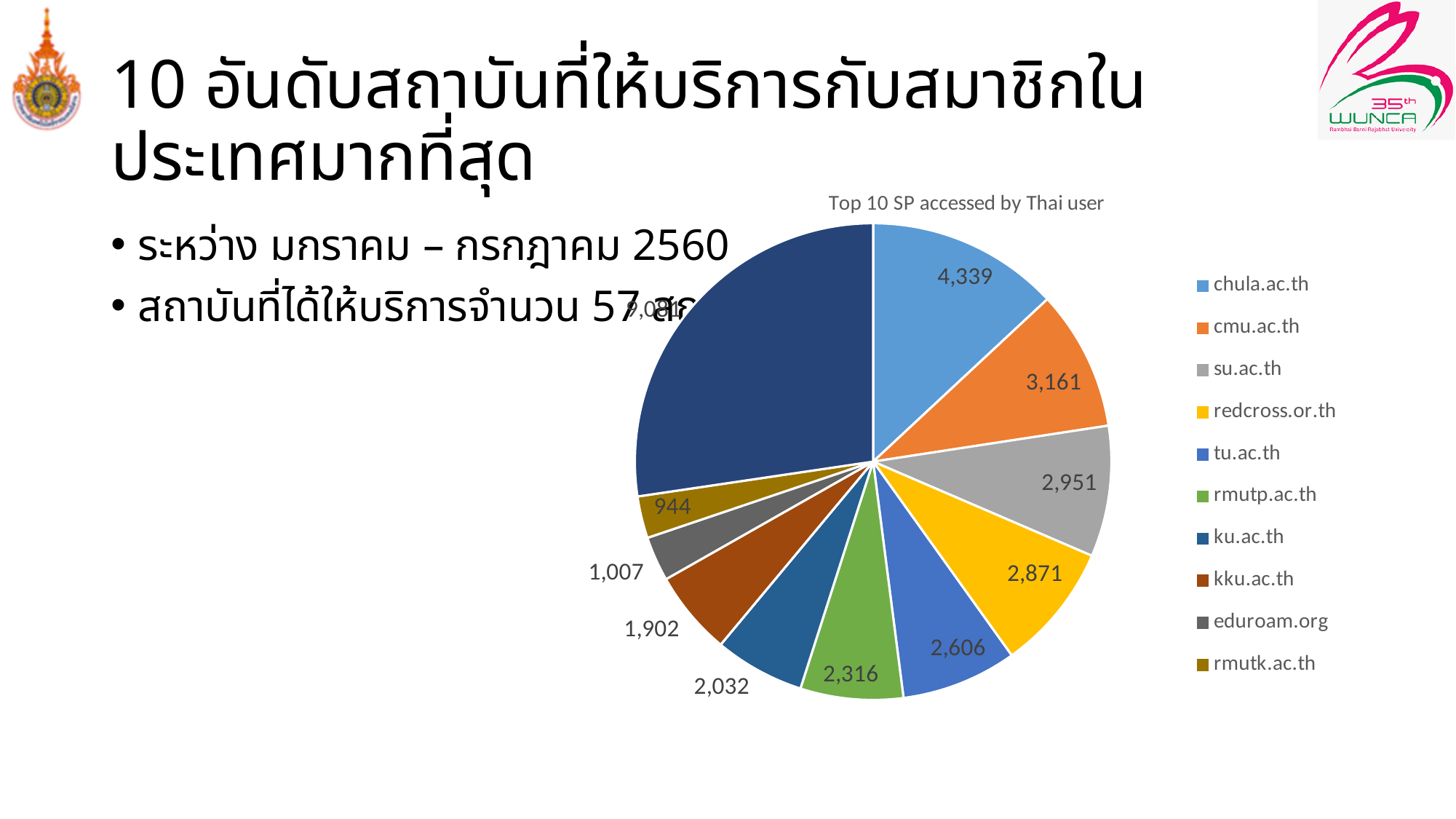
What is the difference between the values for tu.ac.th and rmutp.ac.th? 290 Which is larger, the value for cmu.ac.th or su.ac.th? cmu.ac.th What is the value for eduroam.org? 1,007 What is the value for redcross.or.th? 2,871 What is the value for chula.ac.th? 4,339 How many entries does the chart legend list? 10 What is the difference between the values for chula.ac.th and cmu.ac.th? 1,178 Which category has the smallest slice in the pie chart? rmutk.ac.th What type of chart is shown on the slide? pie chart What is the value for cmu.ac.th? 3,161 What is the value for rmutp.ac.th? 2,316 What is the title of the chart? Top 10 SP accessed by Thai user